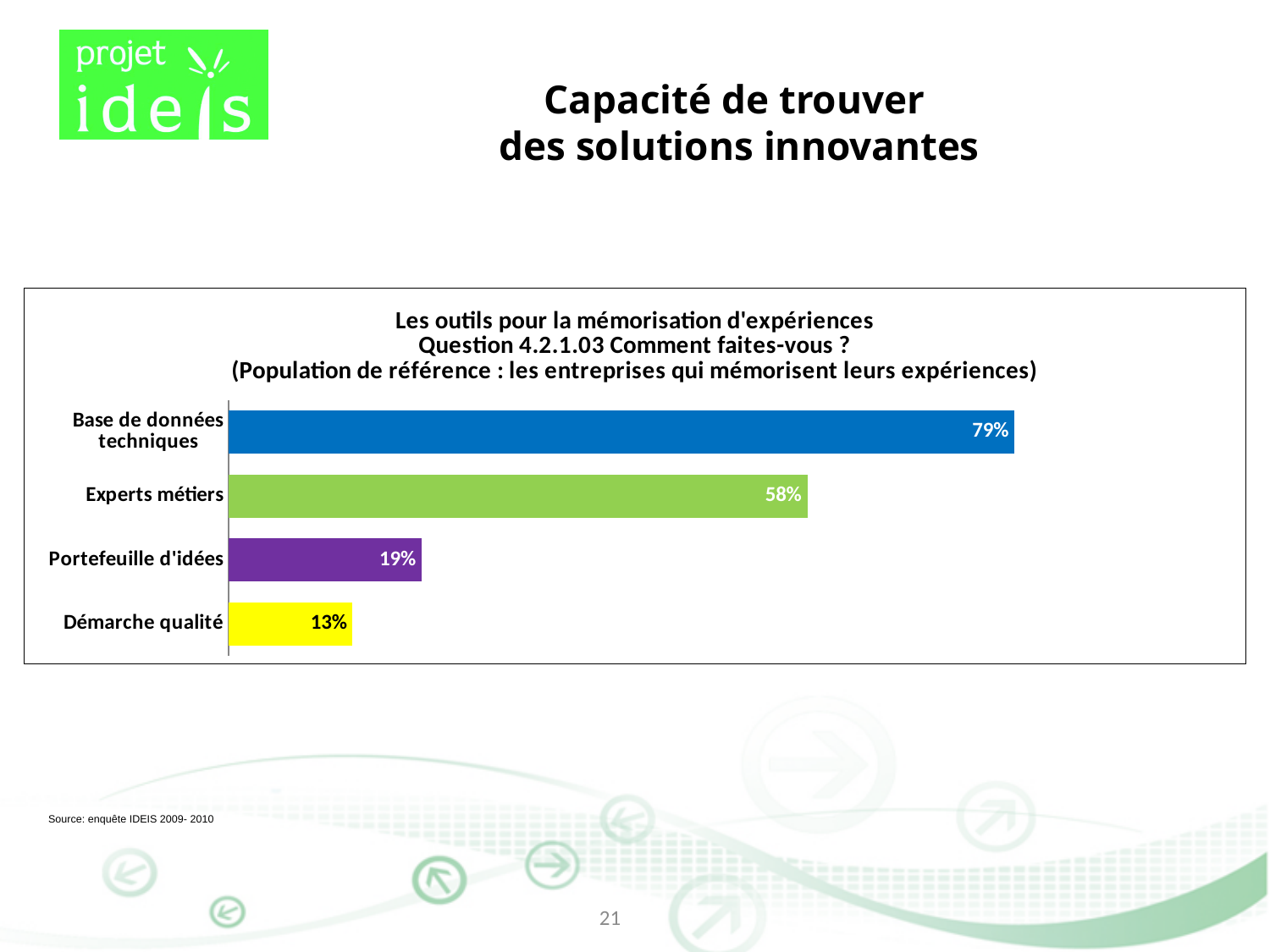
What colour is the bar for Démarche qualité? Yellow What kind of chart is shown on the slide? Bar chart What is the difference between the values for Base de données techniques and Experts métiers? 21% What percentage is shown for Base de données techniques? 79% What percentage is shown for Portefeuille d'idées? 19% What is the difference between the values for Portefeuille d'idées and Démarche qualité? 6% What percentage is shown for Démarche qualité? 13% How many categories are shown in the chart? 4 Which category has the lowest value? Démarche qualité Which category has the highest value? Base de données techniques Which is larger, the value for Experts métiers or the value for Portefeuille d'idées? Experts métiers What percentage is shown for Experts métiers? 58%